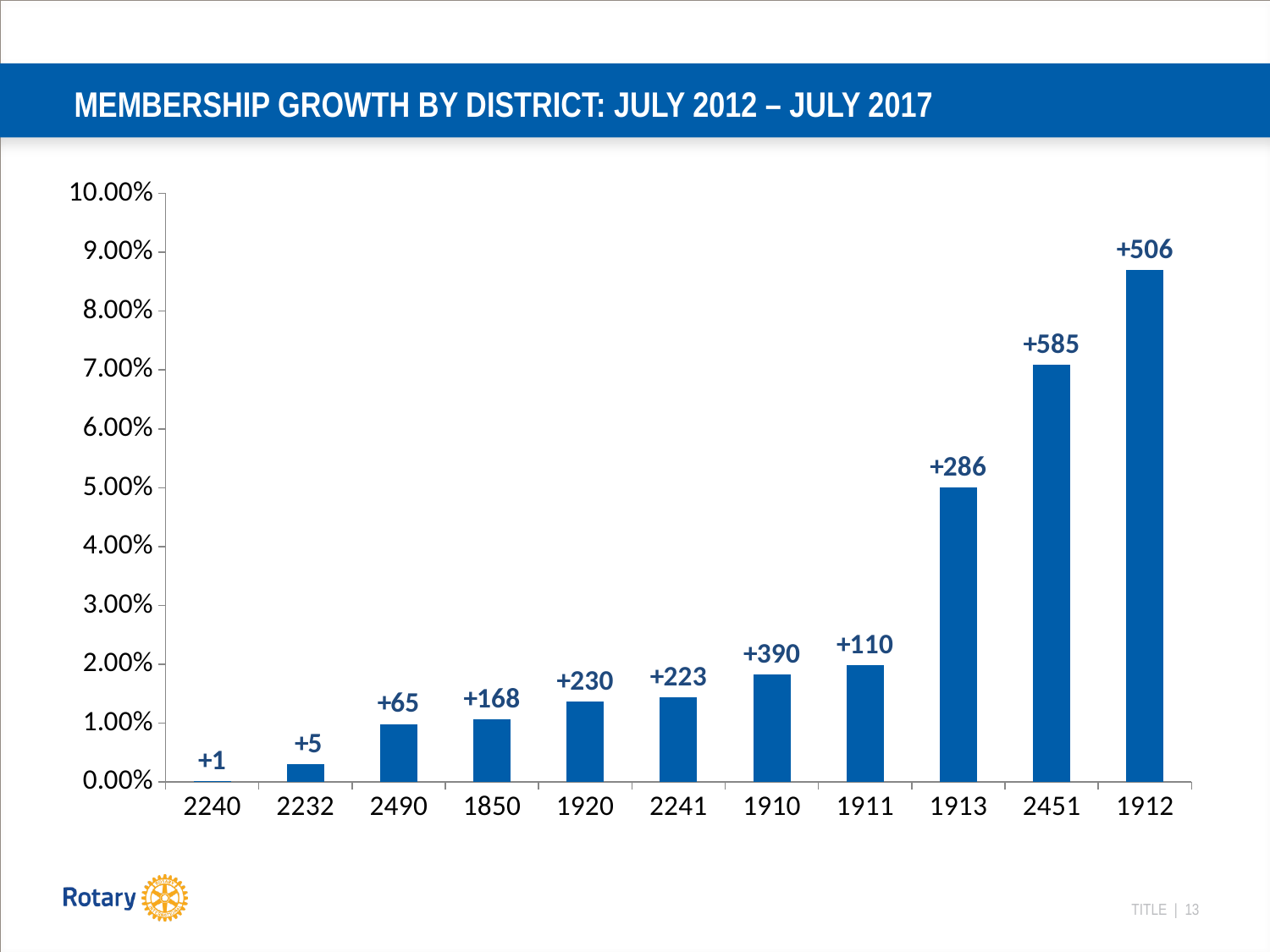
How many districts are shown on the x axis? 11 What is the data label shown above the bar for district 1910? +390 What is the data label shown above the bar for district 2240? +1 Which district has a taller bar, 1913 or 2451? 2451 What is the data label shown above the bar for district 2451? +585 Which district has the shortest bar (lowest growth percentage)? 2240 Is the growth percentage for district 1913 greater or less than 6.00%? less What is the data label shown above the bar for district 1912? +506 Which district has the tallest bar (highest growth percentage)? 1912 What is the data label shown above the bar for district 1913? +286 What kind of chart is shown on the slide? Bar chart Is the growth percentage for district 1912 greater or less than 8.00%? greater